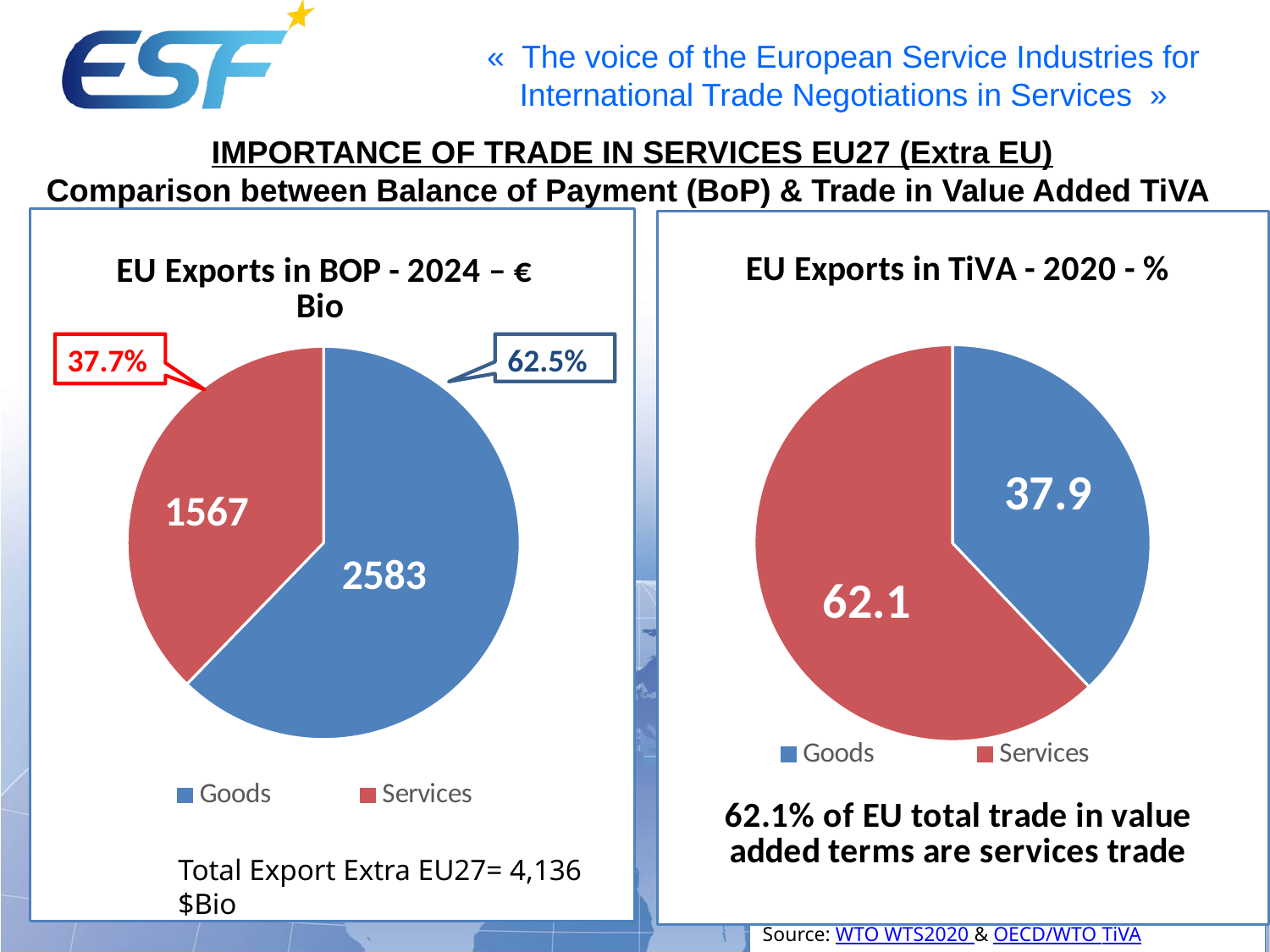
In the 'EU Exports in BOP - 2024' chart, what is the value for Goods? 2583 In the 'EU Exports in BOP - 2024' chart, what percentage share is shown for Services? 37.7% In the 'EU Exports in TiVA - 2020' chart, which category has the smaller slice? Goods In the 'EU Exports in TiVA - 2020' chart, what is the value for Goods? 37.9 In the 'EU Exports in BOP - 2024' chart, which category has the larger slice? Goods How many categories does the legend of the 'EU Exports in TiVA - 2020' chart list? 2 In the 'EU Exports in TiVA - 2020' chart, is the value for Services larger or smaller than the value for Goods? larger In the 'EU Exports in BOP - 2024' chart, what percentage share is shown for Goods? 62.5% What type of chart is used on the left side of the slide? Pie chart In the 'EU Exports in TiVA - 2020' chart, what is the value for Services? 62.1 In the 'EU Exports in BOP - 2024' chart, what is the difference between the Goods and Services values? 1016 In the 'EU Exports in BOP - 2024' chart, what is the value for Services? 1567